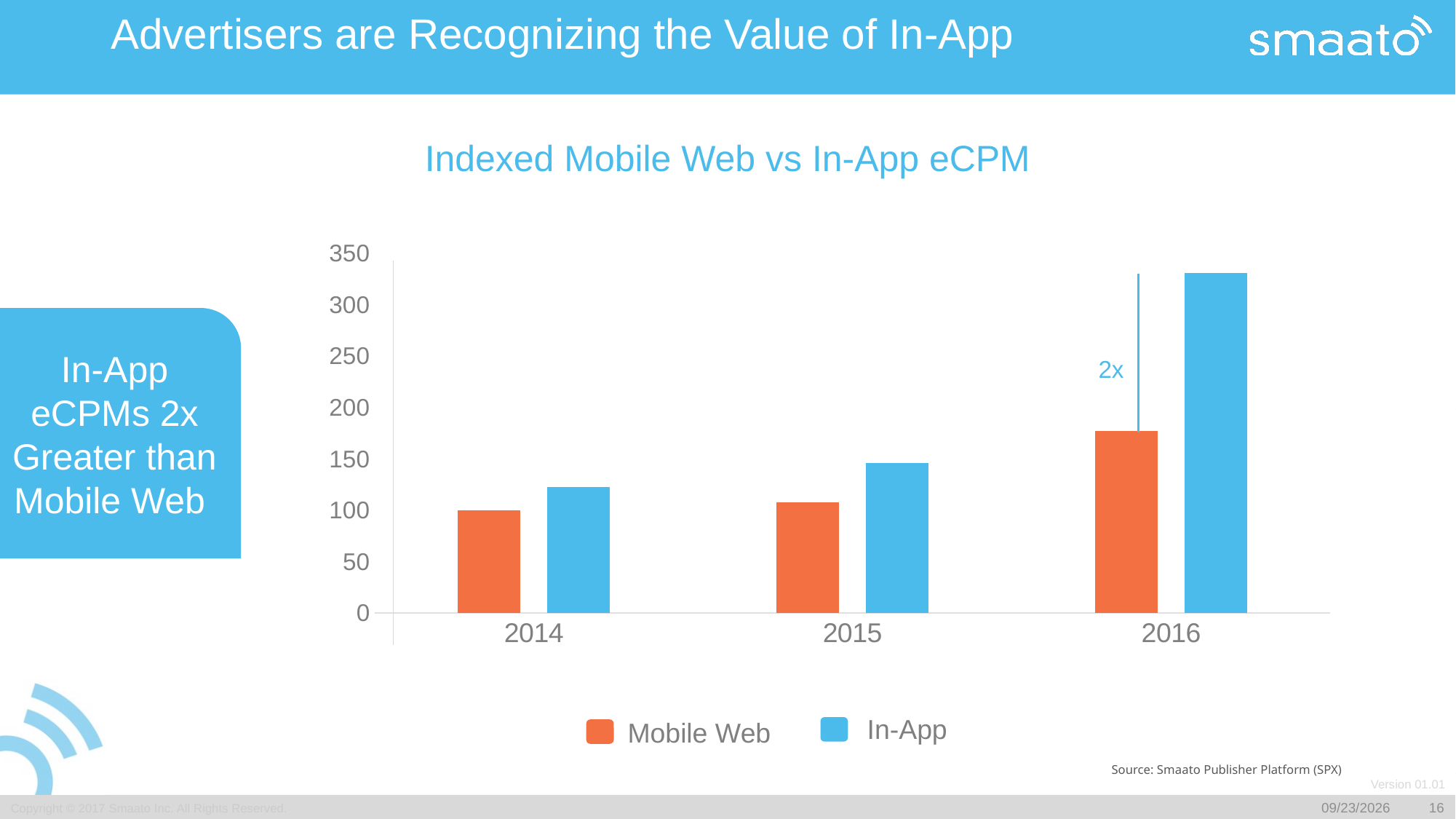
In which year is the In-App value highest? 2016 Is the Mobile Web value for 2016 greater or less than 200? less Is the In-App value for 2015 greater or less than 100? greater What is the title of the chart? Indexed Mobile Web vs In-App eCPM What kind of chart is shown on the slide? bar chart In which year is the Mobile Web value lowest? 2014 How many series does the legend list? 2 How many years are shown on the x axis? 3 Is the In-App value for 2016 greater or less than 300? greater What colour represents the In-App series? blue Do the In-App values rise or fall from 2014 to 2016? rise In 2016, which is larger, Mobile Web or In-App? In-App